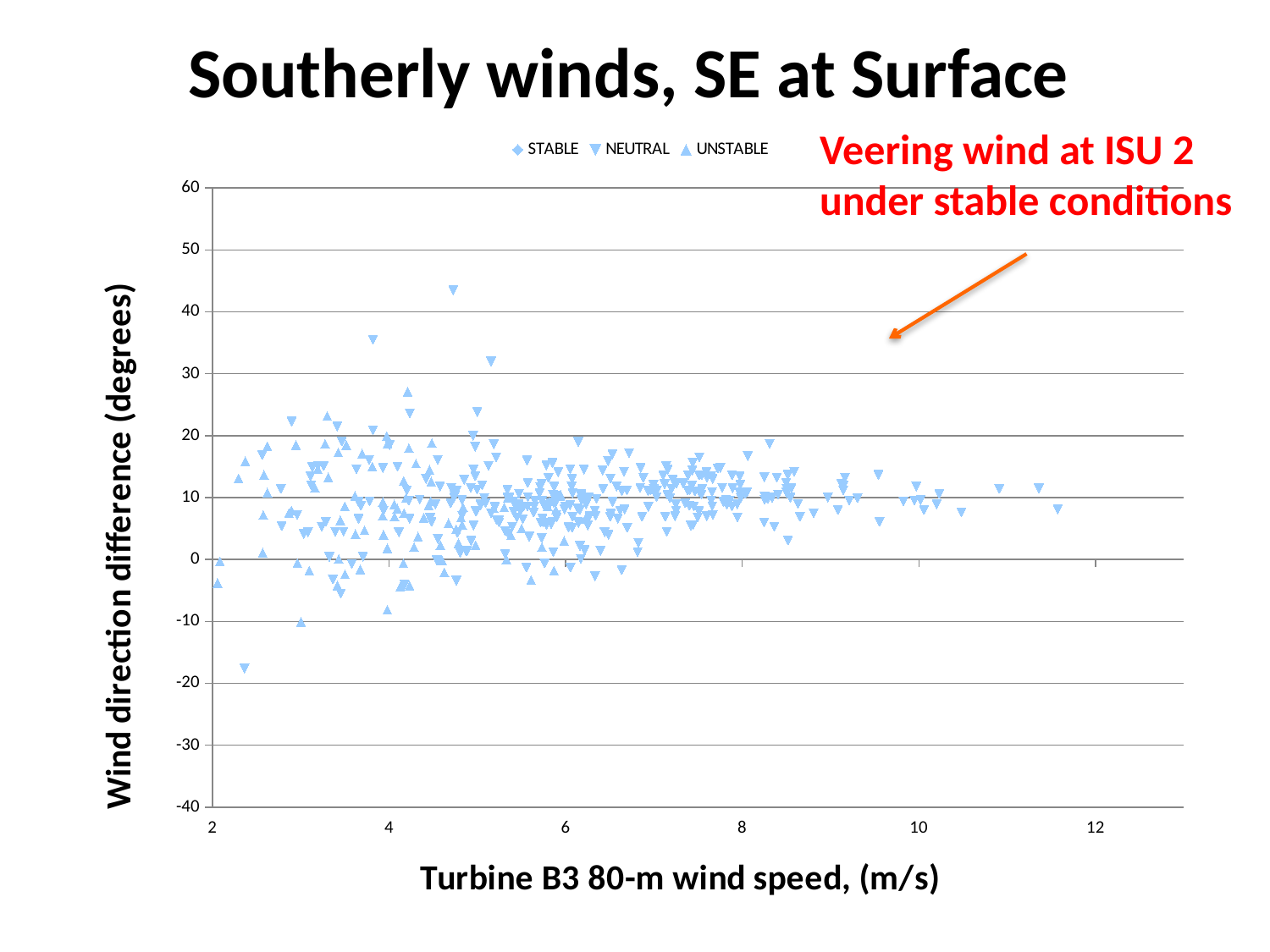
Is the lowest plotted wind direction difference greater or less than -20? greater Is the highest plotted wind direction difference greater or less than 50? less Is the lowest plotted wind direction difference greater or less than -10? less What kind of chart is shown on the slide? scatter chart What are the three series named in the legend? STABLE, NEUTRAL, UNSTABLE How many series does the legend list? 3 What is the title of the x axis? Turbine B3 80-m wind speed, (m/s)